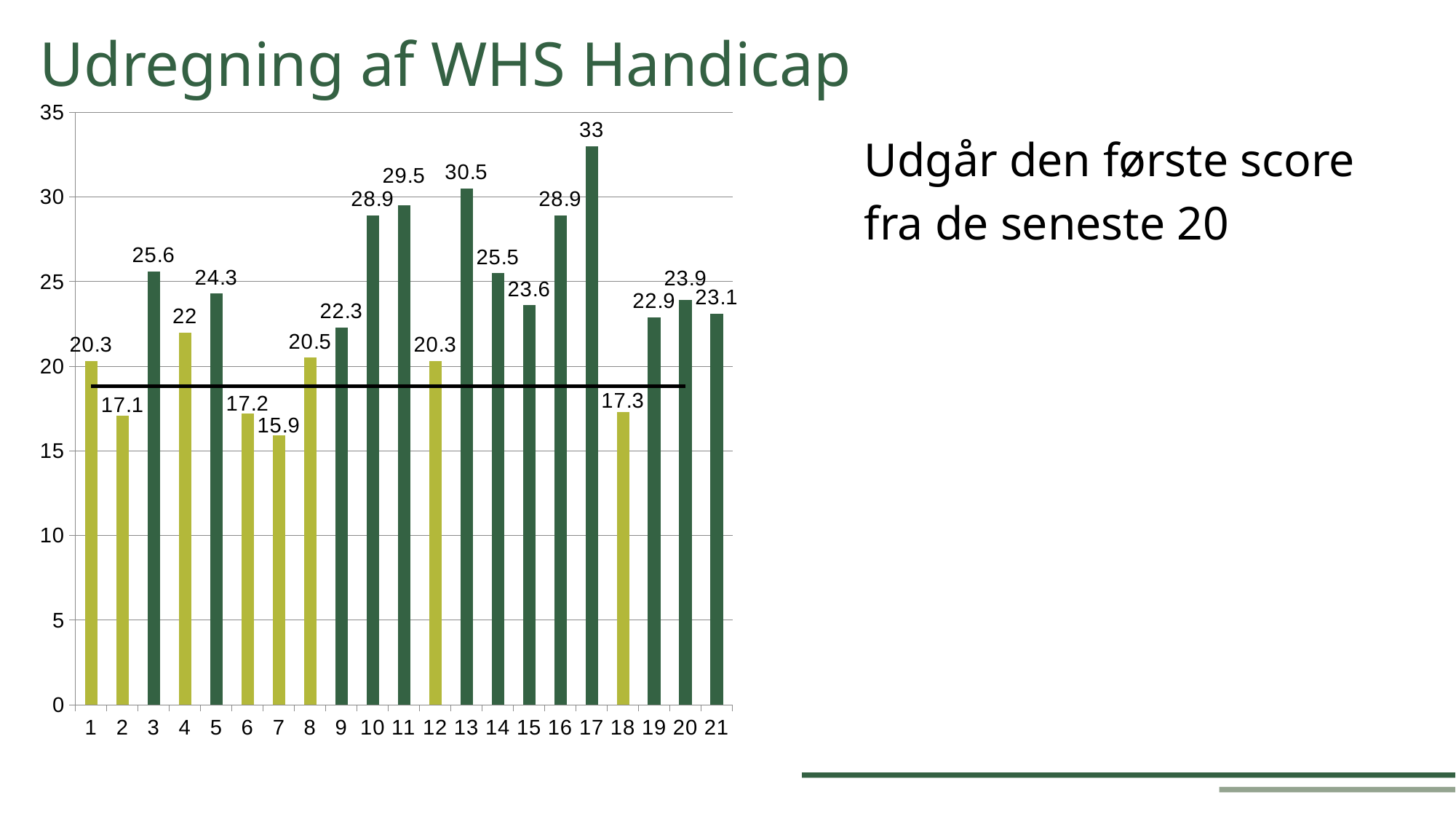
What is the difference between the values for category 13 and category 2? 13.4 What is the value for category 11? 29.5 What is the value for category 7? 15.9 What is the value for category 20? 23.9 What is the value for category 17? 33 What kind of chart is shown on the slide? bar chart Which category has the highest value? 17 Which category has the lowest value? 7 Is the value for category 10 greater or less than 25? greater How many categories are shown on the x axis? 21 What is the title of the slide containing the chart? Udregning af WHS Handicap Which is larger, the value for category 3 or the value for category 5? category 3